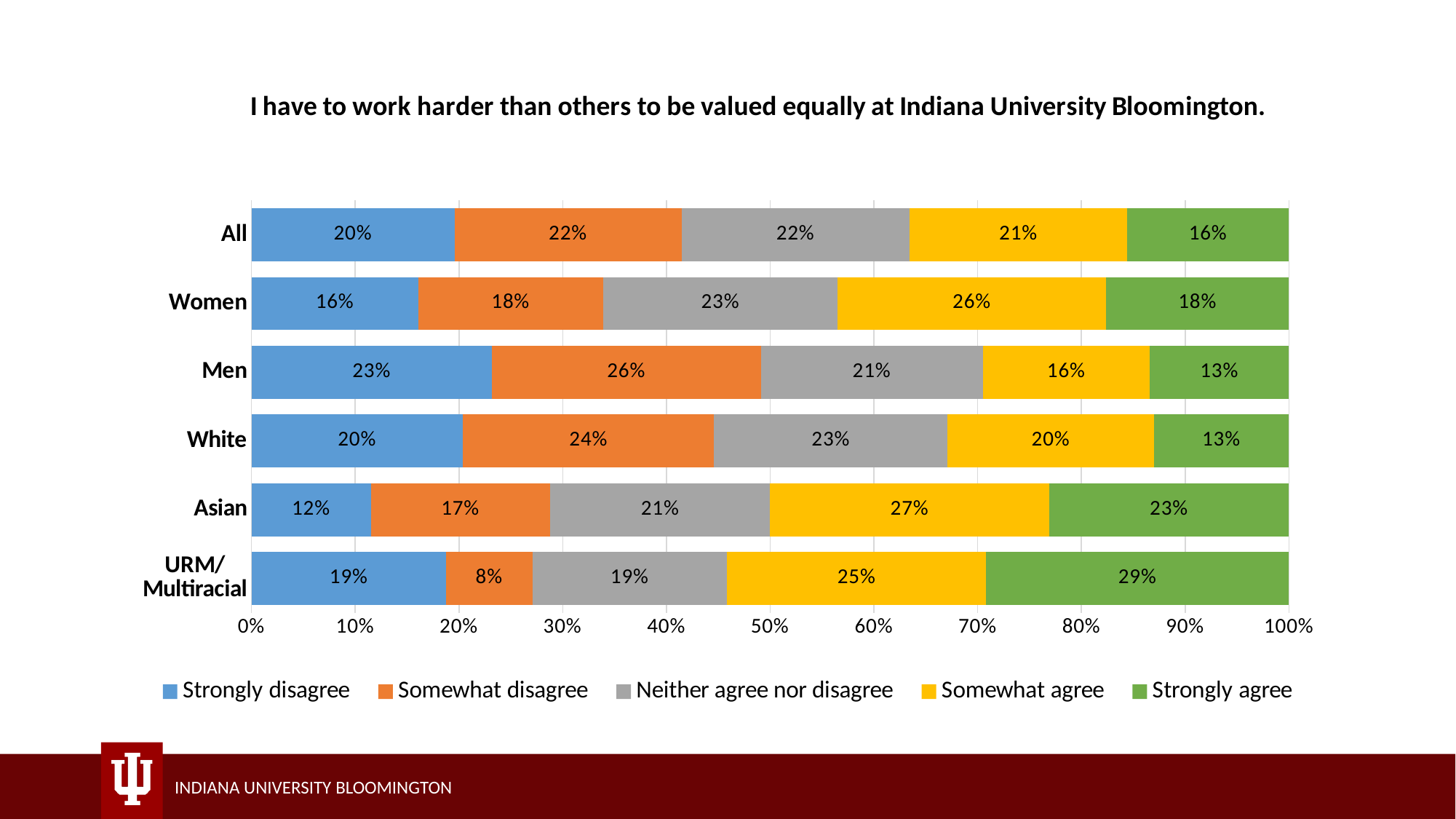
What kind of chart is shown on the slide? Stacked bar chart How many response categories does the legend list? 5 Which group has the lowest percentage of Strongly disagree responses? Asian What percentage of Asian respondents somewhat agree? 27% Which group has the highest percentage of Strongly agree responses? URM/Multiracial What percentage of URM/Multiracial respondents strongly agree? 29% What percentage of Men strongly disagree? 23% Which group has a larger Strongly agree percentage, Asian or White? Asian Which group has the lowest percentage of Somewhat disagree responses? URM/Multiracial What is the total of the stacked bar for White respondents? 100% How many groups (categories) are shown on the chart? 6 How much higher is the Somewhat agree percentage for Women than for Men? 10 percentage points